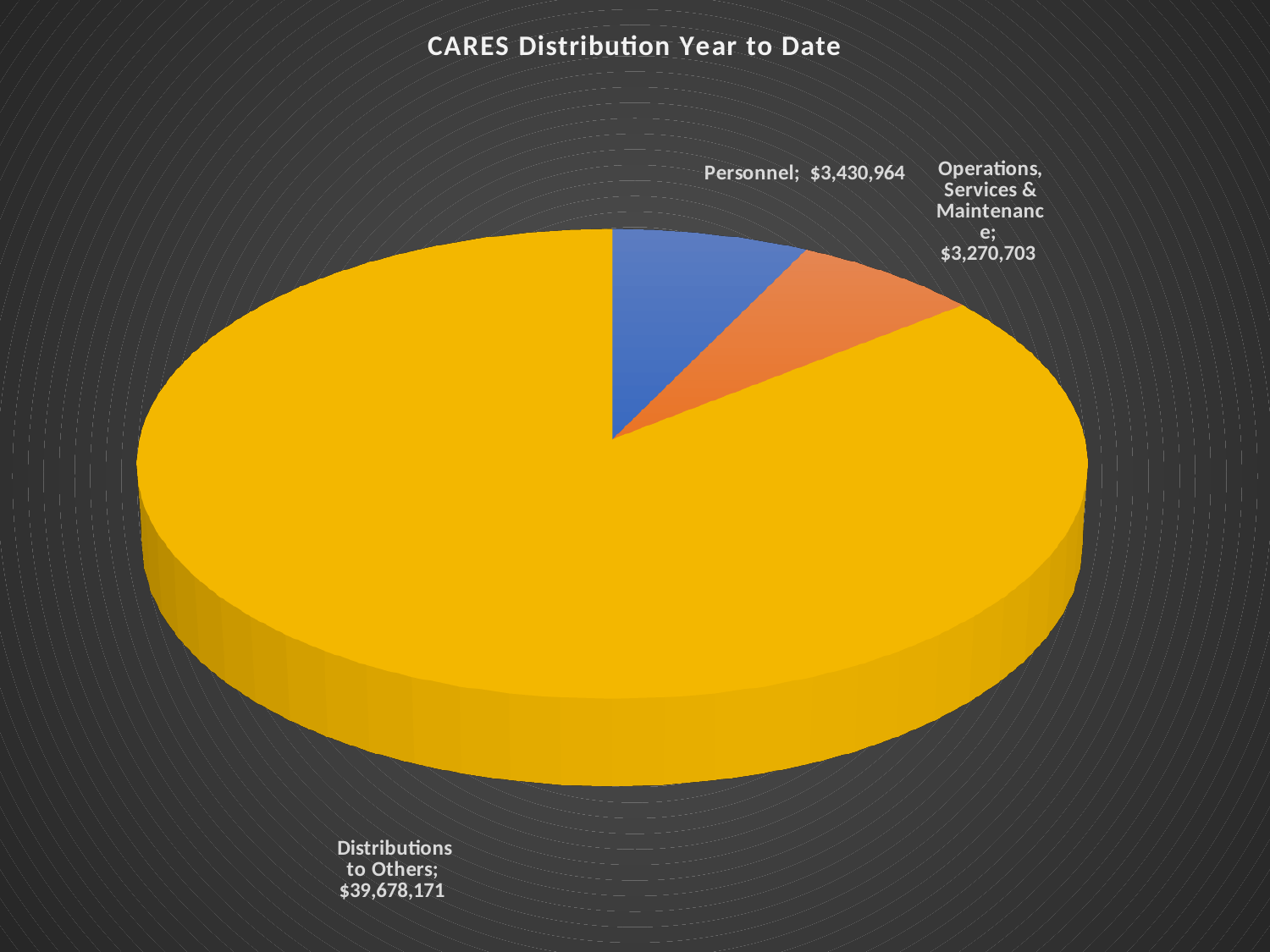
Which is larger, Personnel or Operations, Services & Maintenance? Personnel How many slices does the pie chart have? 3 What kind of chart is shown on the slide? Pie chart What is the title of the chart? CARES Distribution Year to Date Which category has the smallest slice? Operations, Services & Maintenance What is the total of all three slices? $46,379,838 What is the difference between Personnel and Operations, Services & Maintenance? $160,261 What is the value for Personnel? $3,430,964 Which category has the largest slice? Distributions to Others What colour is the Distributions to Others slice? Yellow What is the value for Operations, Services & Maintenance? $3,270,703 What is the value for Distributions to Others? $39,678,171